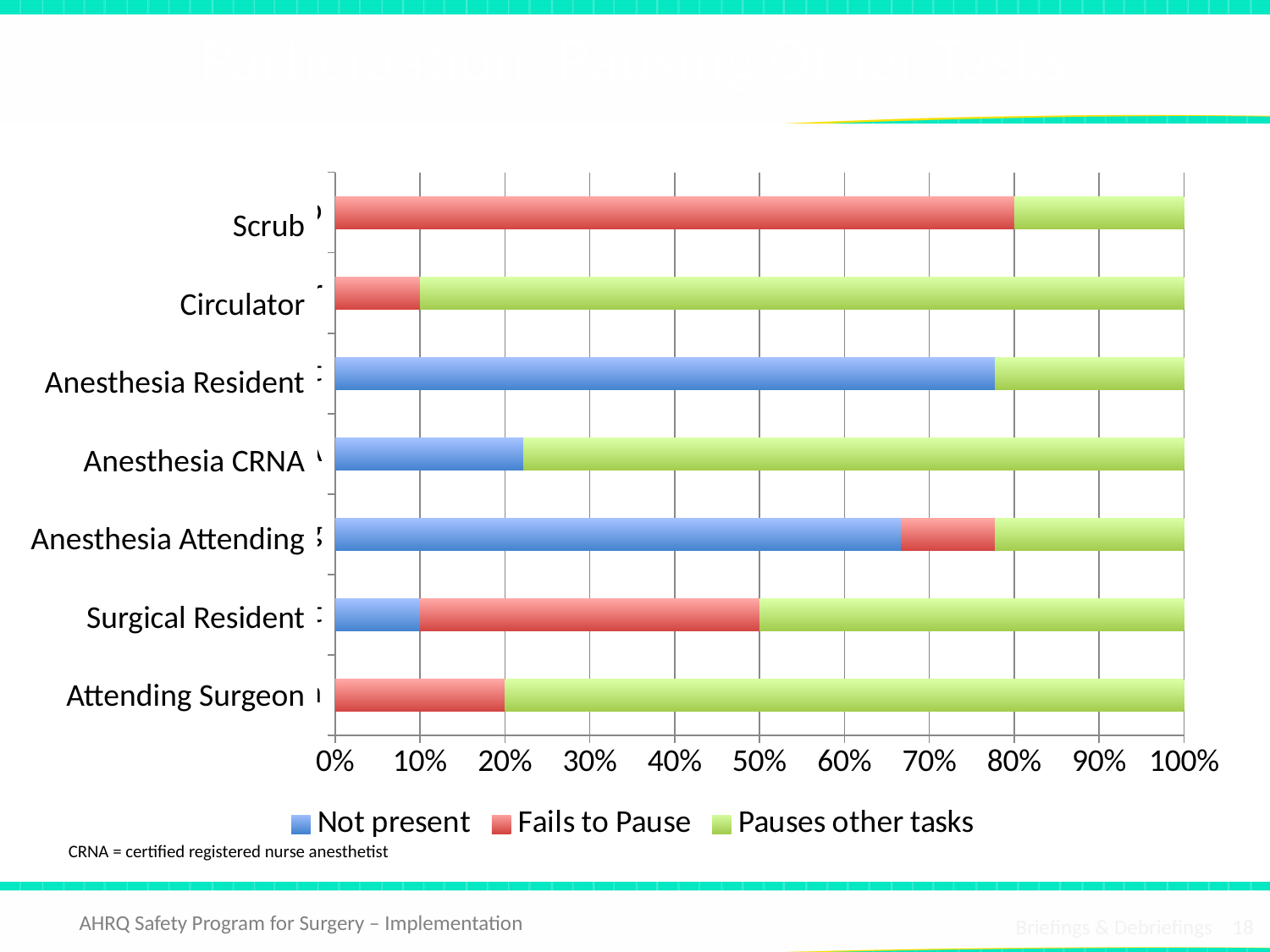
Which role has the largest 'Pauses other tasks' segment? Circulator Which role has the largest 'Fails to Pause' segment? Scrub Which colour represents 'Pauses other tasks' in the chart legend? Green What kind of chart is shown on the slide? Stacked bar chart Which is larger: the 'Fails to Pause' share for Scrub or for Attending Surgeon? Scrub What is the maximum value shown on the horizontal axis of the chart? 100% Is the 'Not present' share for Anesthesia Attending greater or less than 60%? greater Is the 'Not present' share for Anesthesia CRNA greater or less than 30%? less Is the 'Fails to Pause' share for Scrub greater or less than 70%? greater How many roles (categories) are listed on the vertical axis of the chart? 7 How many series does the chart legend list? 3 Which role has the largest 'Not present' segment? Anesthesia Resident